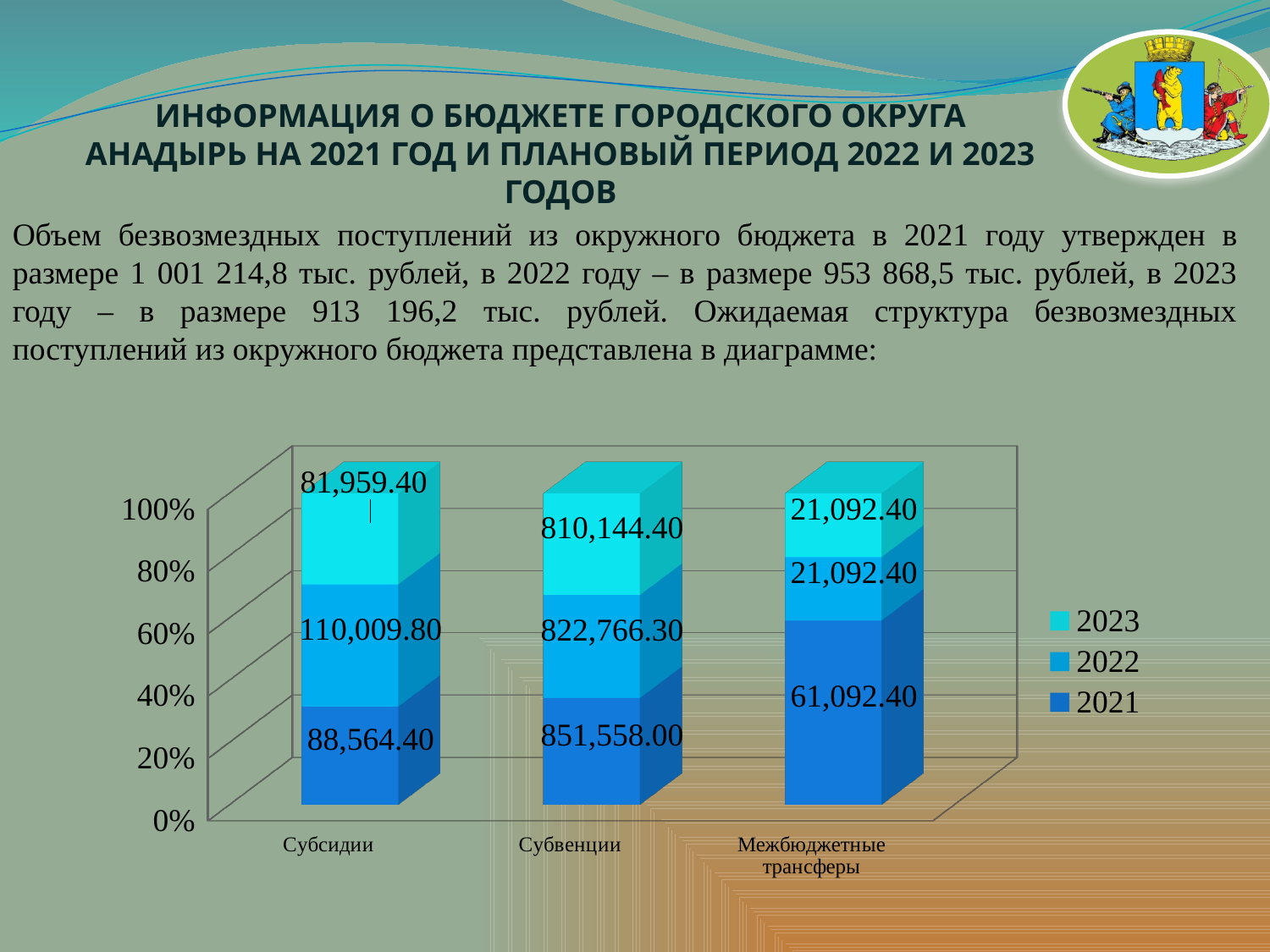
Which category has the lowest value in the 2023 series? Межбюджетные трансферы How many series does the legend list? 3 What is the total of the three values in the Межбюджетные трансферы bar? 103,277.20 What is the value for Субвенции in the 2022 series? 822,766.30 What is the value for Субсидии in the 2021 series? 88,564.40 How many categories are shown on the x axis? 3 What is the difference between the 2021 and 2022 values for Межбюджетные трансферы? 40,000.00 What is the value for Межбюджетные трансферы in the 2023 series? 21,092.40 What is the difference between the 2022 and 2021 values for Субсидии? 21,445.40 What kind of chart is shown on the slide? Stacked bar chart For Субвенции, which is larger: the 2021 value or the 2023 value? 2021 Which category has the highest value in the 2021 series? Субвенции